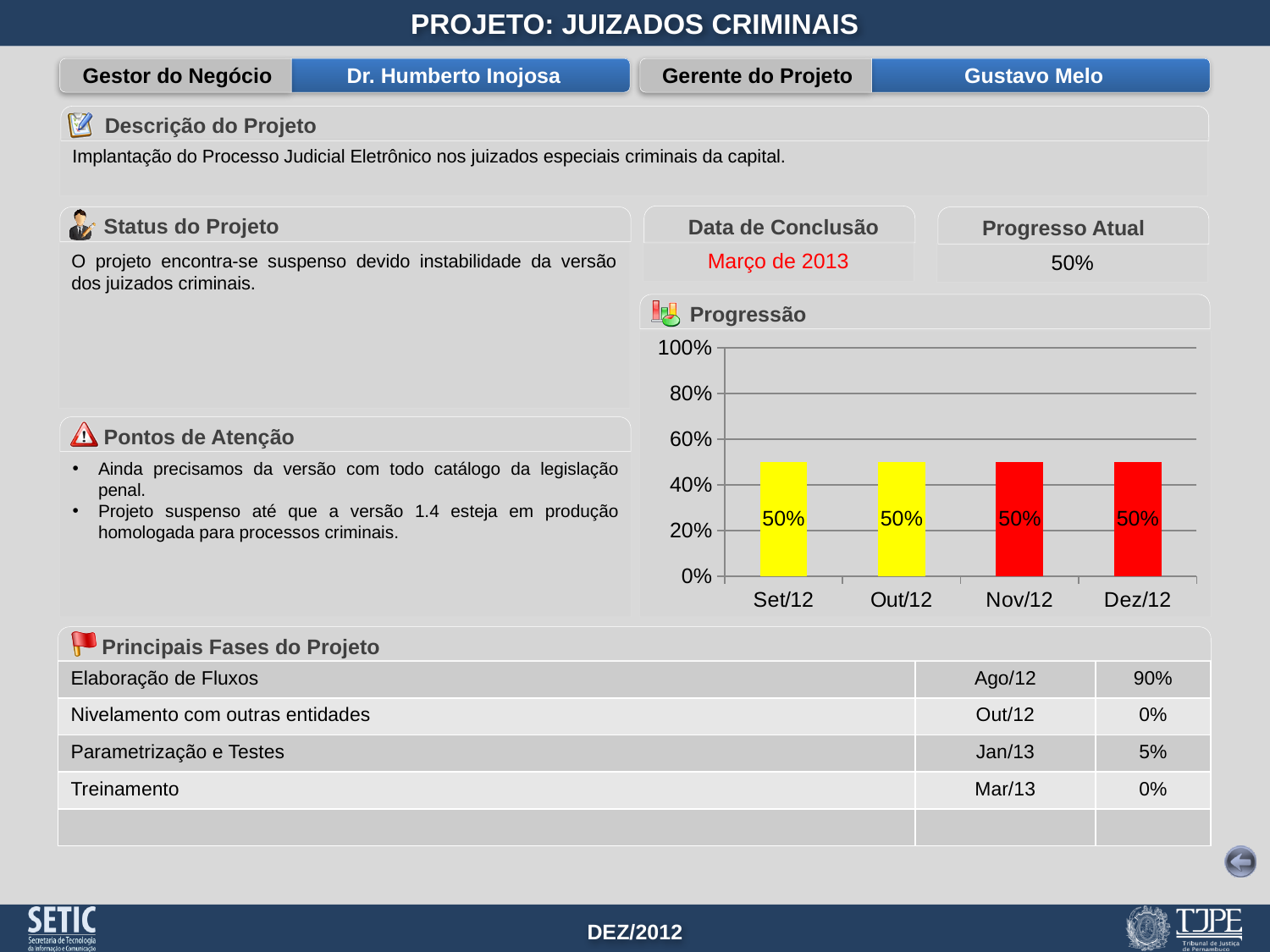
How many months are shown on the x axis of the Progressão chart? 4 Do the values in the Progressão chart rise, fall or stay flat from Set/12 to Dez/12? stay flat Is the value for Out/12 in the Progressão chart greater or less than 20%? greater What is the difference between the values for Dez/12 and Set/12 in the Progressão chart? 0% What is the value for Set/12 in the Progressão chart? 50% What is the value for Out/12 in the Progressão chart? 50% Is the value for Nov/12 in the Progressão chart greater or less than 80%? less What is the value for Dez/12 in the Progressão chart? 50% What colour are the bars for Nov/12 and Dez/12 in the Progressão chart? red What is the value for Nov/12 in the Progressão chart? 50% What type of chart is shown under "Progressão"? bar chart What colour are the bars for Set/12 and Out/12 in the Progressão chart? yellow